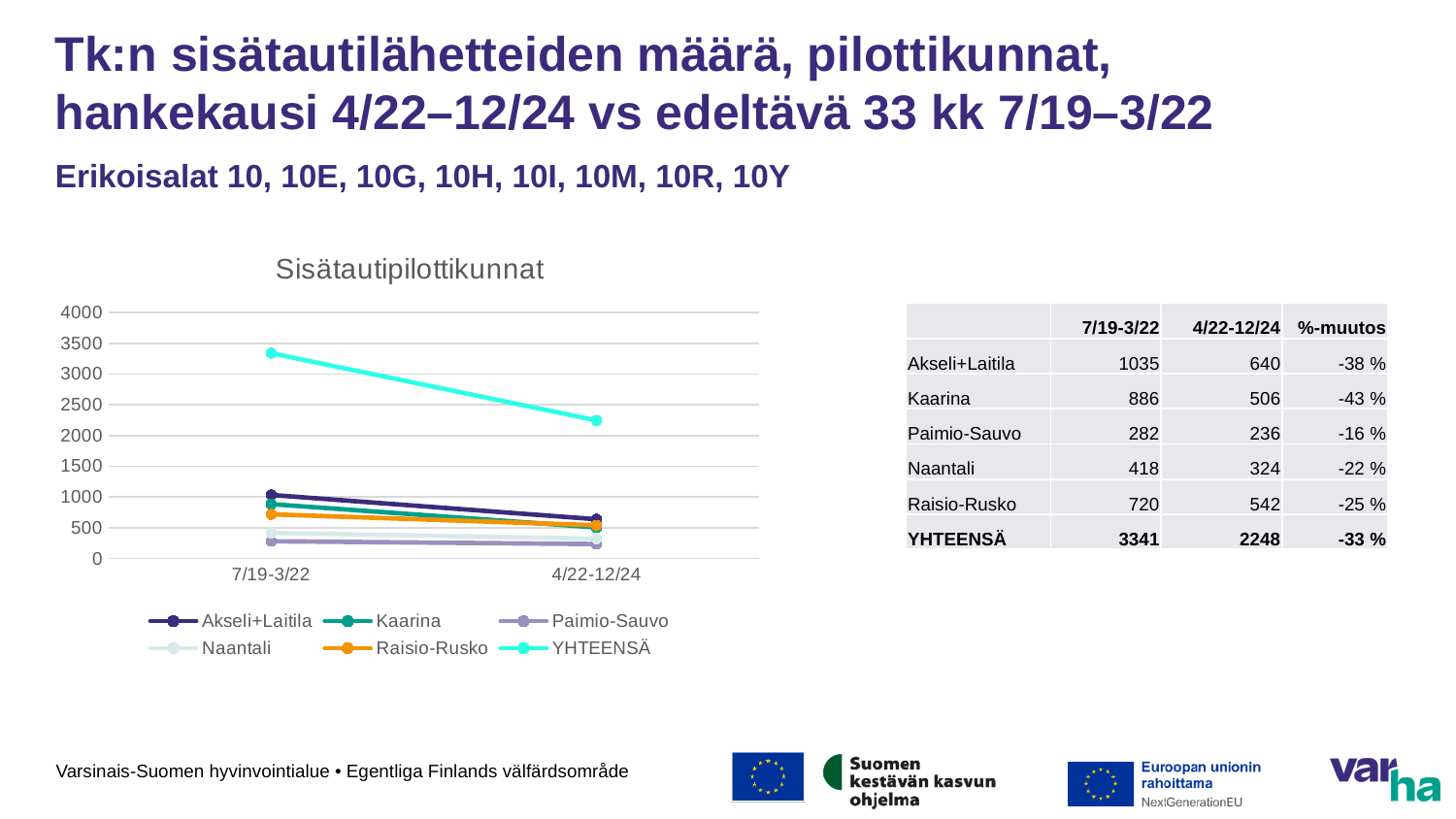
What is the difference between the YHTEENSÄ values at 7/19-3/22 and 4/22-12/24? 1093 Does the YHTEENSÄ line rise or fall from 7/19-3/22 to 4/22-12/24? fall What is the title of the chart? Sisätautipilottikunnat How many series does the chart legend list? 6 Is the value for Paimio-Sauvo at 4/22-12/24 greater or less than 500? less How many points are there along the x axis of the chart? 2 What kind of chart is shown on the slide? line chart Is the value for YHTEENSÄ at 7/19-3/22 greater or less than 3000? greater Which series has the highest value at 7/19-3/22? YHTEENSÄ What is the value for Kaarina at 4/22-12/24? 506 Which series has the lowest value at 4/22-12/24? Paimio-Sauvo Which is larger at 7/19-3/22, Akseli+Laitila or Kaarina? Akseli+Laitila